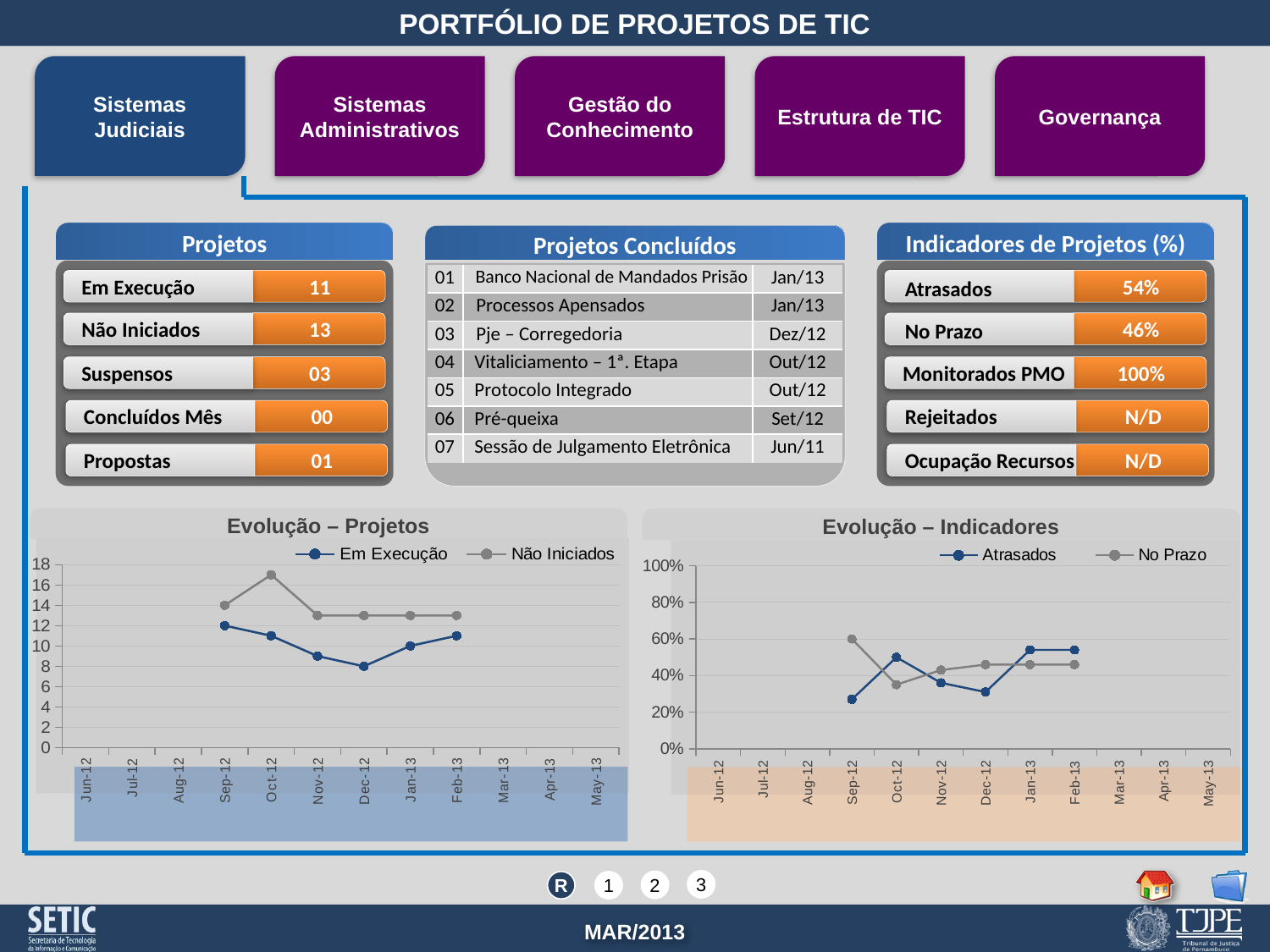
In the 'Evolução – Projetos' chart, which month has the lowest value for Em Execução? Dec-12 What type of chart is the 'Evolução – Projetos' chart? line chart How many series does the legend of the 'Evolução – Indicadores' chart list? 2 In the 'Evolução – Indicadores' chart, what is the value of No Prazo for Sep-12? 60% In the 'Evolução – Projetos' chart, is the value of Não Iniciados for Oct-12 greater or less than 16? greater In the 'Evolução – Projetos' chart, what is the value of Em Execução for Dec-12? 8 In the 'Evolução – Indicadores' chart, is the value of Atrasados for Sep-12 greater or less than 40%? less In the 'Evolução – Projetos' chart, what is the value of Não Iniciados for Sep-12? 14 In the 'Evolução – Projetos' chart, which month has the highest value for Não Iniciados? Oct-12 In the 'Evolução – Projetos' chart, which series is higher in Nov-12, Em Execução or Não Iniciados? Não Iniciados In the 'Evolução – Projetos' chart, what is the value of Em Execução for Sep-12? 12 In the 'Evolução – Indicadores' chart, which series is higher in Jan-13, Atrasados or No Prazo? Atrasados